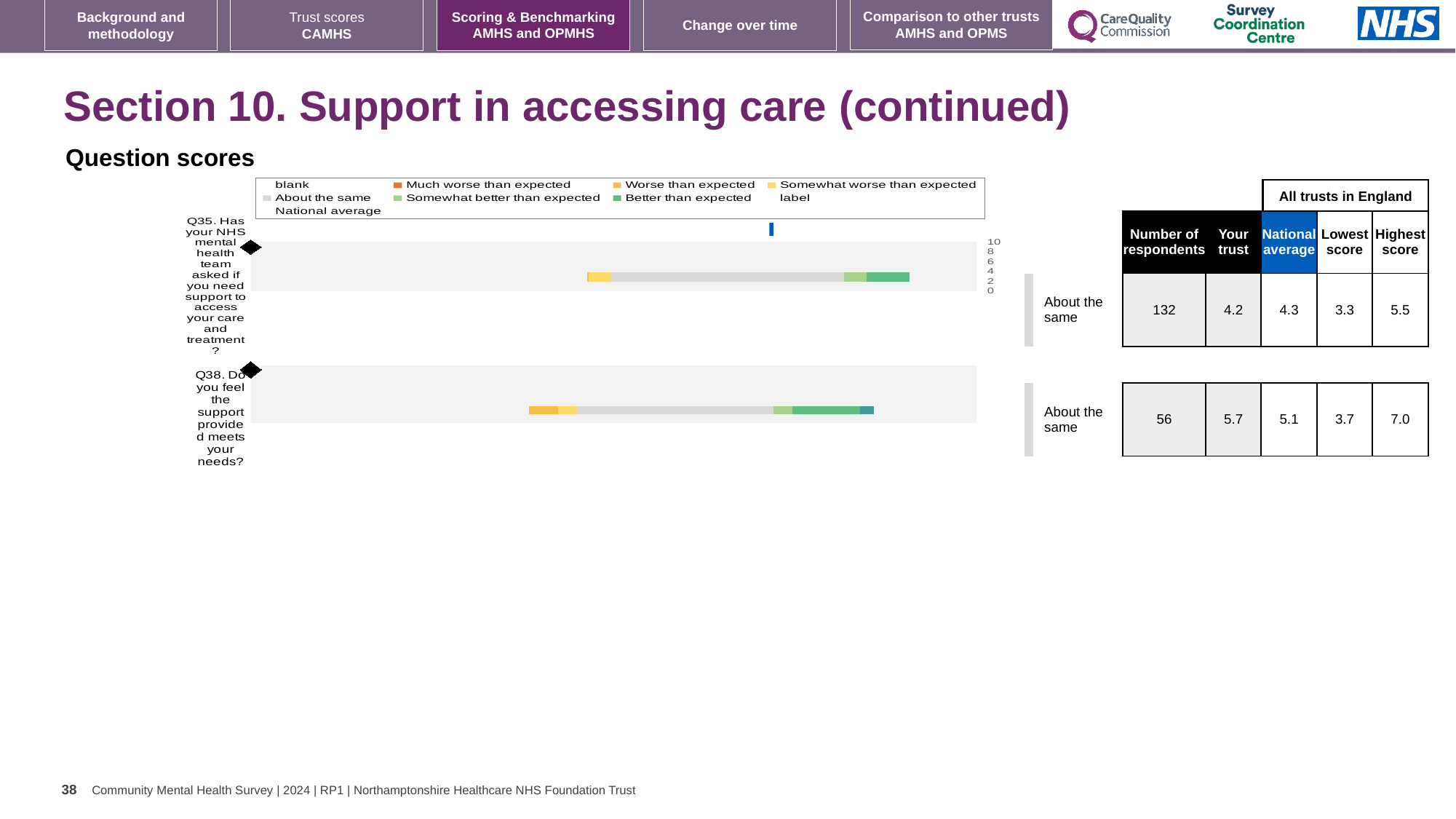
According to the table beside the chart, how many respondents answered Q35? 132 Which of the two questions has the higher 'Your trust' score in the table? Q38 What kind of chart is shown under 'Question scores'? bar chart Using the table beside the chart, what is the difference between the highest score and the lowest score for Q38? 3.3 How many questions (categories) are plotted in the chart? 2 What colour does the legend use for 'Much worse than expected'? orange According to the table beside the chart, what is the 'Your trust' score for Q38? 5.7 According to the table beside the chart, what is the 'Your trust' score for Q35? 4.2 How many entries does the chart legend list? 9 What comparison label is shown next to the chart for Q35? About the same According to the table beside the chart, what is the national average for Q38? 5.1 For Q38, which is larger in the table: the 'Your trust' score or the national average? Your trust